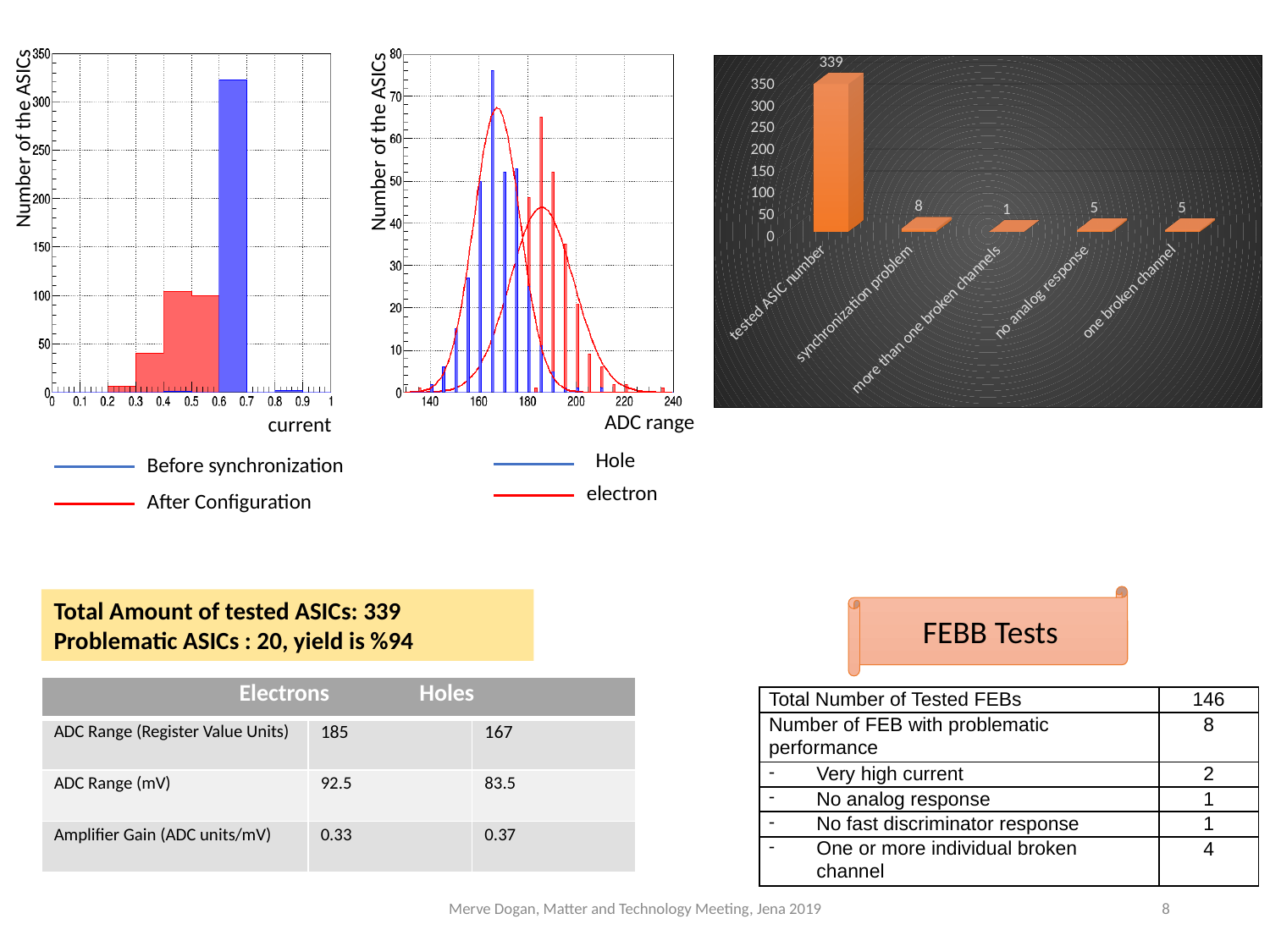
In the 3D bar chart on the right, which category has the lowest value? more than one broken channels In the 3D bar chart on the right, what is the value for 'synchronization problem'? 8 What kind of chart is the chart on the right of the slide? bar chart In the 3D bar chart on the right, what is the difference between 'tested ASIC number' and 'synchronization problem'? 331 In the 3D bar chart on the right, which is larger: 'synchronization problem' or 'no analog response'? synchronization problem In the left histogram (current), is the peak of the blue 'Before synchronization' bar greater or less than 300? greater In the 3D bar chart on the right, what is the value for 'tested ASIC number'? 339 How many series does the legend of the middle histogram (ADC range) list? 2 In the 3D bar chart on the right, what is the value for 'more than one broken channels'? 1 How many categories are shown in the 3D bar chart on the right? 5 In the middle histogram (ADC range), is the tallest blue 'Hole' bar greater or less than 70? greater In the 3D bar chart on the right, which category has the highest value? tested ASIC number